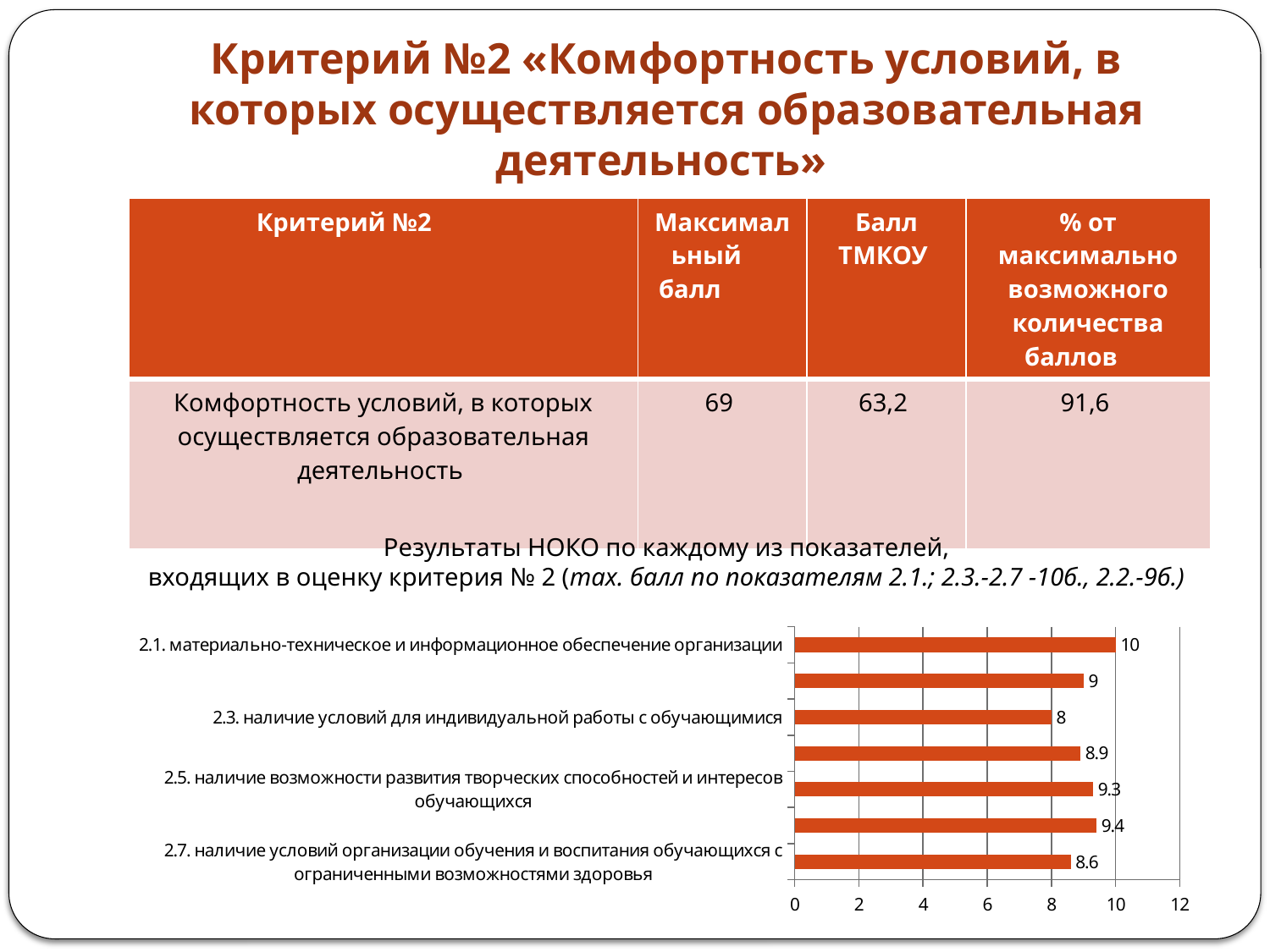
What is the value for indicator 2.7 (наличие условий организации обучения и воспитания обучающихся с ограниченными возможностями здоровья)? 8.6 Which labelled indicator has the lowest value in the chart? 2.3 What is the difference between the values for indicators 2.1 and 2.3? 2 What is the difference between the values for indicators 2.5 and 2.7? 0.7 What is the maximum value shown on the chart's horizontal axis? 12 What is the value for indicator 2.5 (наличие возможности развития творческих способностей и интересов обучающихся)? 9.3 Which labelled indicator has the highest value in the chart? 2.1 Which has the larger value, indicator 2.5 or indicator 2.7? 2.5 What kind of chart is shown on the slide? bar chart What is the value for indicator 2.3 (наличие условий для индивидуальной работы с обучающимися)? 8 How many bars are plotted in the chart? 7 What is the value for indicator 2.1 (материально-техническое и информационное обеспечение организации)? 10